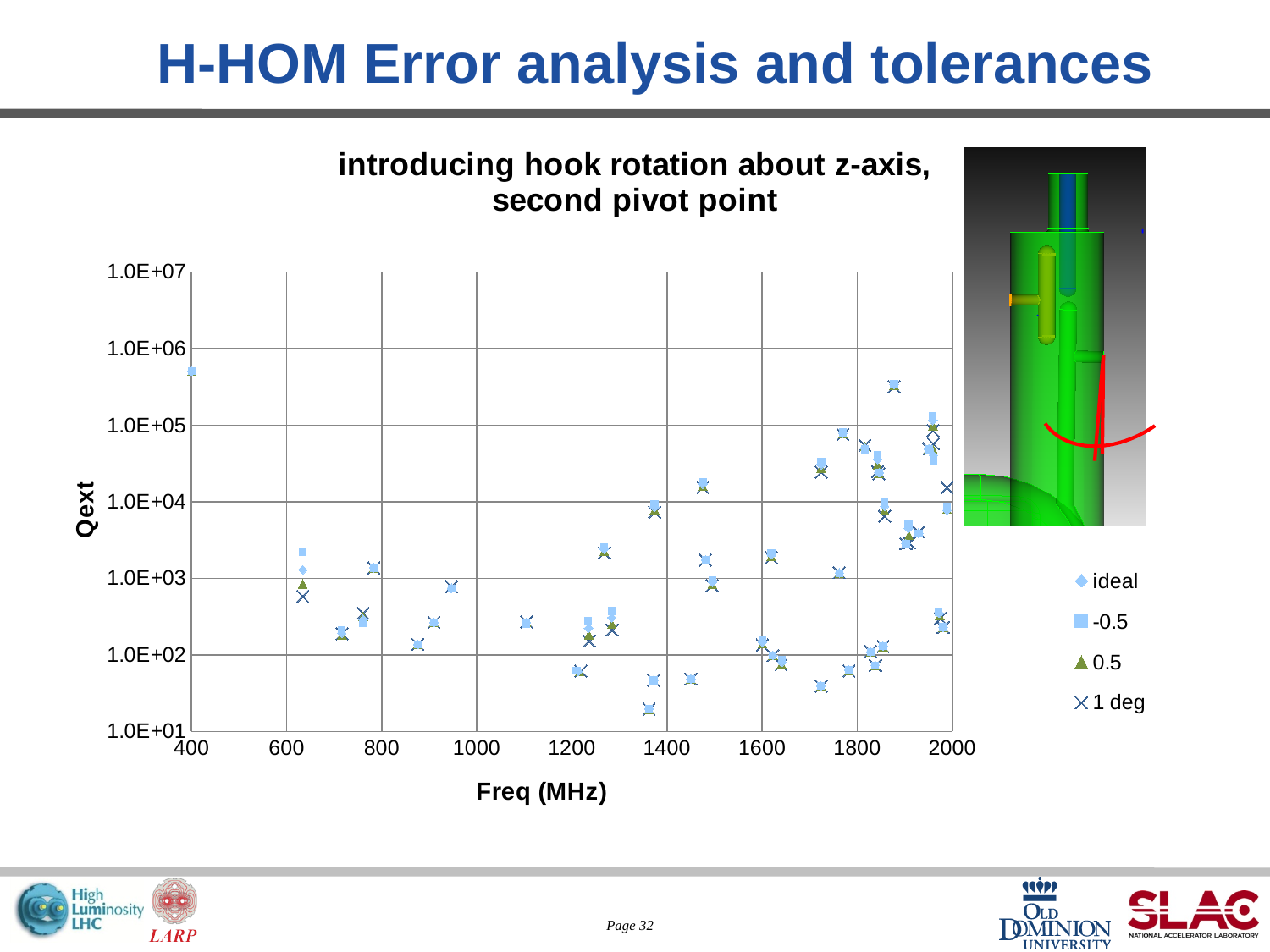
Is the Qext value of the point plotted near 400 MHz greater or less than 1.0E+05? greater How many series does the chart legend list? 4 What is the highest frequency shown on the chart's x-axis? 2000 What kind of chart is shown on the slide? scatter chart Which series in the legend is plotted with an X marker? 1 deg Is the lowest Qext value plotted on the chart greater or less than 1.0E+02? less Is the highest Qext value plotted on the chart greater or less than 1.0E+06? less What is the lowest frequency shown on the chart's x-axis? 400 What is the label of the chart's y-axis? Qext What is the title of the chart? introducing hook rotation about z-axis, second pivot point What is the highest value shown on the chart's y-axis? 1.0E+07